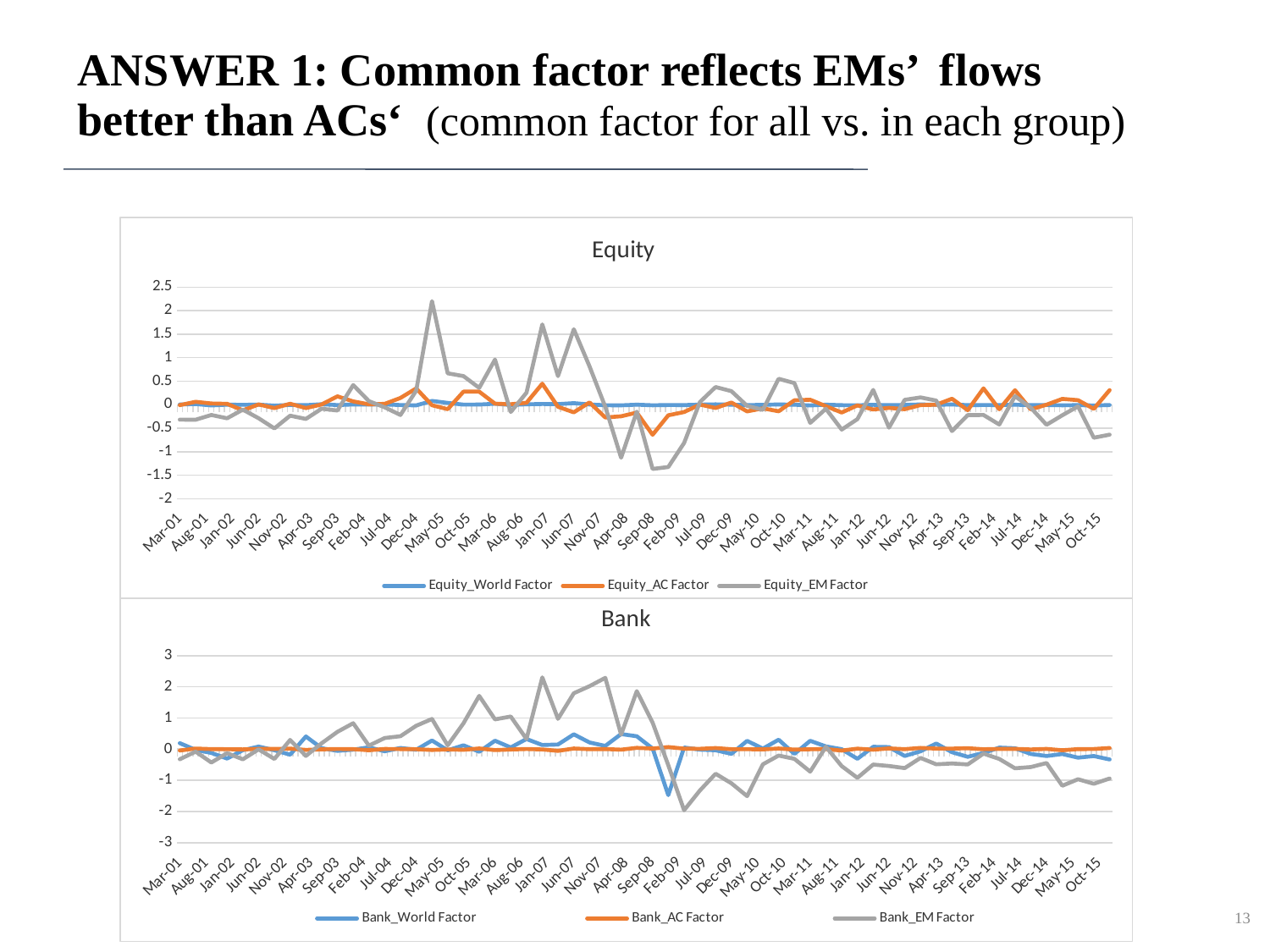
In the Bank chart, which series reaches the highest value on the chart? Bank_EM Factor In the Equity chart, is the lowest value of Equity_EM Factor around Sep-08 greater or less than -1? less How many series does the legend of the Equity chart list? 3 In the Bank chart, which series is drawn in grey according to the legend? Bank_EM Factor What are the titles of the two charts on the slide? Equity and Bank In the Bank chart, is the lowest value of Bank_EM Factor around Jul-09 greater or less than -1? less How many series does the legend of the Bank chart list? 3 What kind of chart is the Bank chart? line chart In the Equity chart, which series reaches the highest value on the chart? Equity_EM Factor What kind of chart is the Equity chart? line chart In the Bank chart, is the peak value of Bank_EM Factor around Jan-07 greater or less than 1? greater